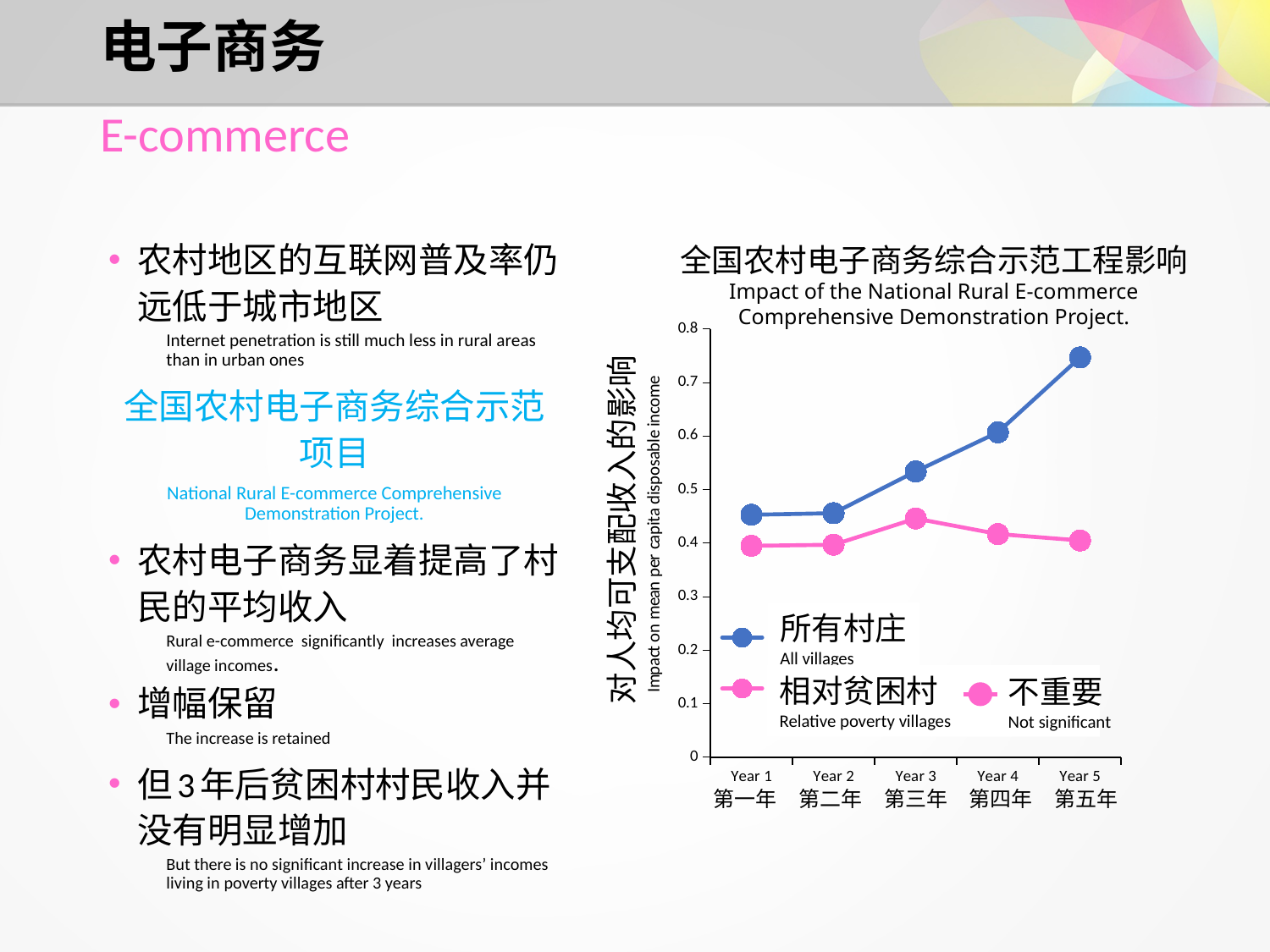
In which year does the 'Relative poverty villages' line reach its highest value? Year 3 What kind of chart is shown on the slide? line chart How many years are shown on the x axis of the chart? 5 Is the value for 'All villages' in Year 4 greater or less than 0.5? greater How many lines are plotted in the chart? 2 In which year does the 'All villages' line reach its highest value? Year 5 Is the value for 'All villages' in Year 5 greater or less than 0.7? greater What is the English title of the chart? Impact of the National Rural E-commerce Comprehensive Demonstration Project. Is the value for 'Relative poverty villages' in Year 3 greater or less than 0.5? less Does the 'All villages' line rise or fall from Year 1 to Year 5? rise In Year 5, which series has the larger value, 'All villages' or 'Relative poverty villages'? All villages Which colour is used for the 'All villages' line? blue